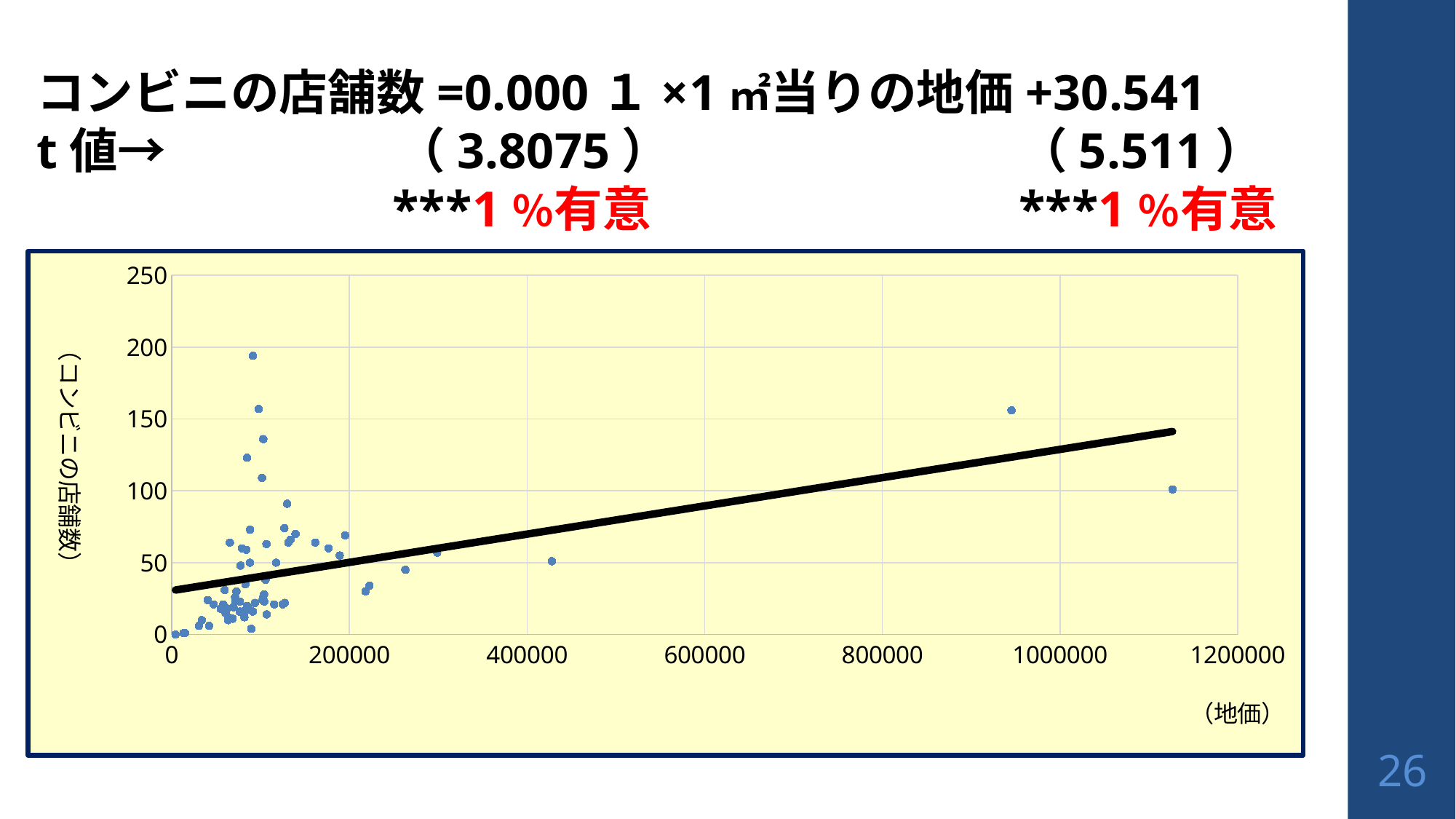
What is the label of the y axis? コンビニの店舗数 Is the y value of the point near x = 950000 greater or less than 100? greater What is the label of the x axis? 地価 Is the y value of the point near x = 430000 greater or less than 100? less What is the highest value shown on the x axis? 1200000 What kind of chart is shown on the slide? scatter chart Is the y value of the highest point in the scatter plot greater or less than 150? greater Does the fitted trend line rise or fall as land price (地価) increases along the x axis? rises